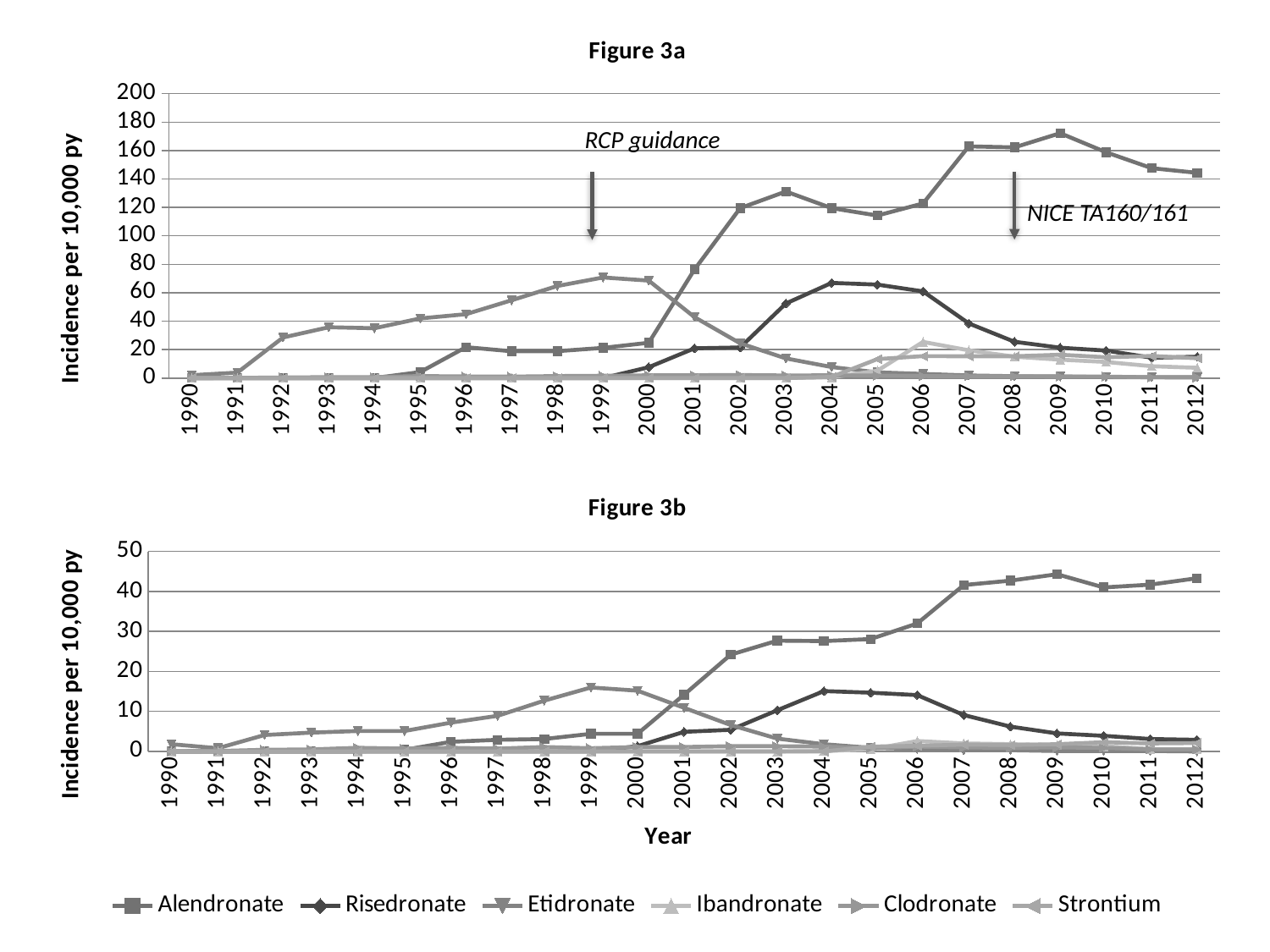
In Figure 3a, in which year does Alendronate reach its highest value? 2009 In Figure 3a, is the Etidronate value for 1999 greater or less than 80? less How many series does the shared legend list? 6 In Figure 3b, which is larger in 2004: Risedronate or Etidronate? Risedronate Which guidance annotation is marked with an arrow at 1999 in Figure 3a? RCP guidance How many years are plotted along the x axis of Figure 3b? 23 In Figure 3a, does the Risedronate line rise or fall from 2004 to 2012? fall What is the y-axis label of Figure 3a? Incidence per 10,000 py In Figure 3b, is the Alendronate value for 2012 greater or less than 40? greater What kind of chart is Figure 3a? line chart In Figure 3b, in which year does Etidronate reach its highest value? 1999 In Figure 3a, is the Alendronate value for 2009 greater or less than 160? greater